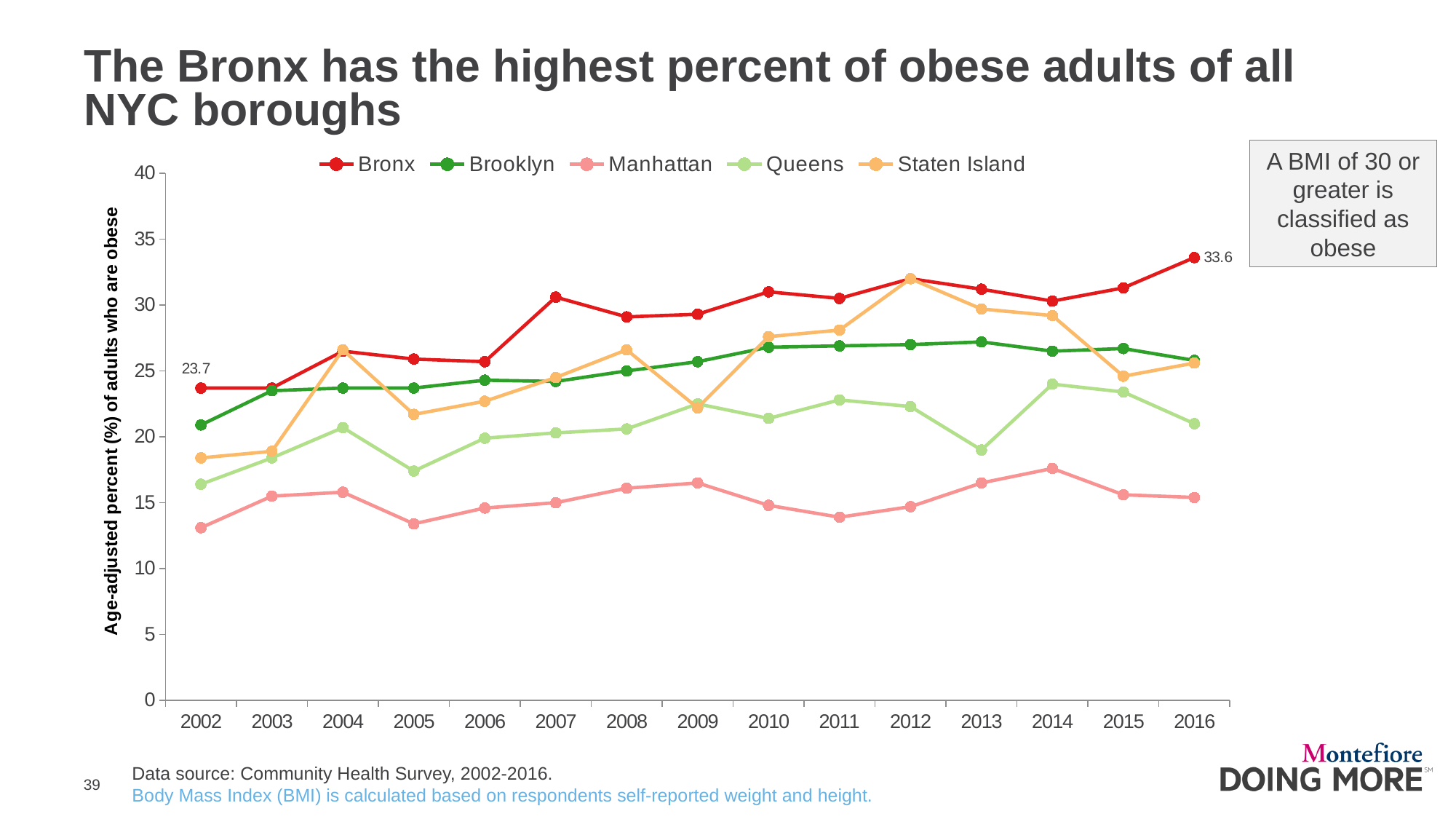
Which borough has the highest value in 2016? Bronx What is the value for the Bronx in 2016? 33.6 What is the label of the y axis? Age-adjusted percent (%) of adults who are obese Is the value for Manhattan in 2011 greater or less than 15? less Which borough has the lowest value in 2016? Manhattan How many series does the legend list? 5 In 2013, which is larger, the value for Queens or the value for Brooklyn? Brooklyn What type of chart is shown on the slide? line chart What is the value for the Bronx in 2002? 23.7 How many years are shown on the x axis? 15 Is the value for Staten Island in 2012 greater or less than 30? greater By how much did the Bronx value change from 2002 to 2016? 9.9